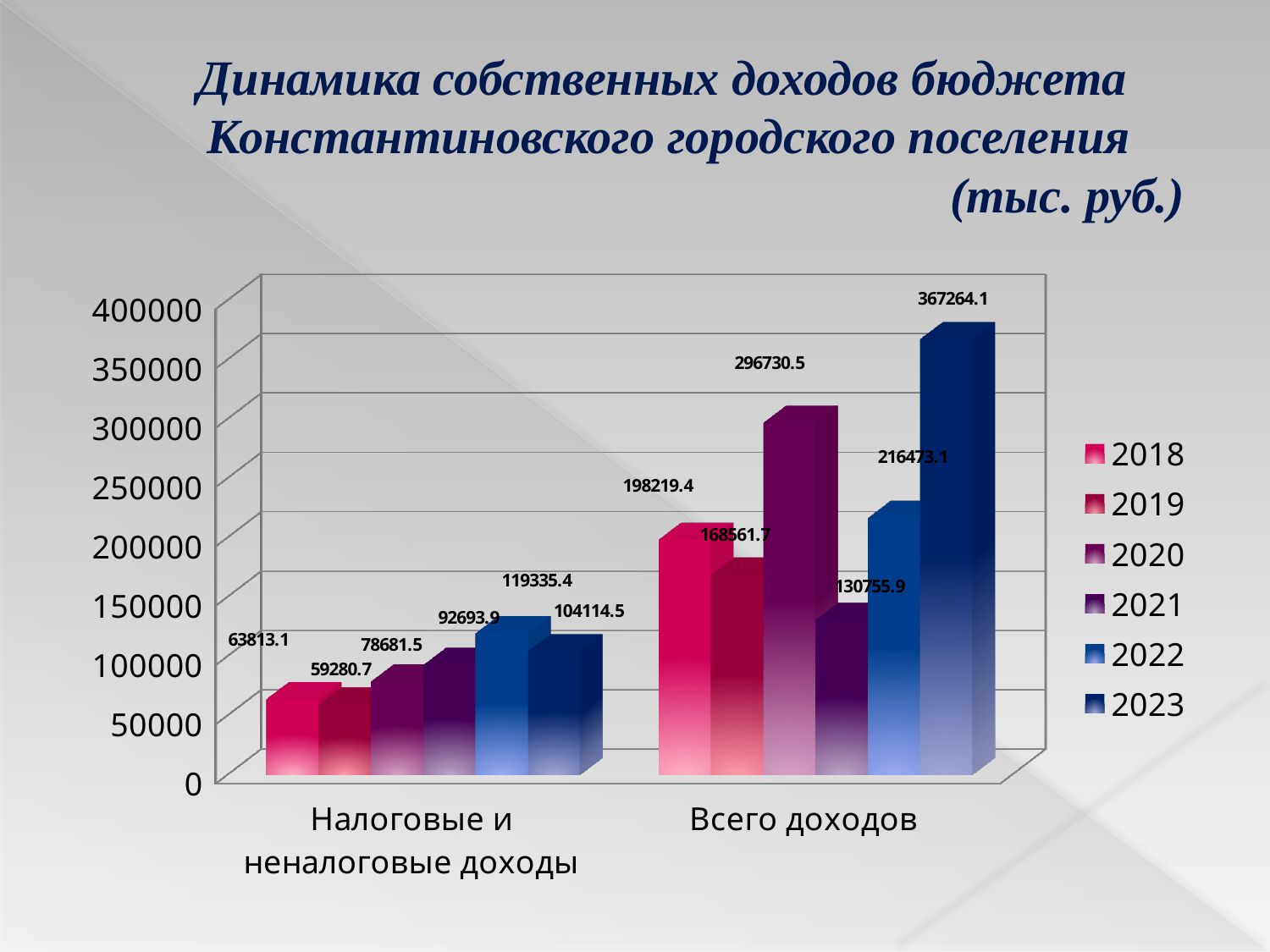
What unit is given in the chart title? тыс. руб. What is the value for 2021 in the "Всего доходов" category? 130755.9 Which year has the lowest value in the "Налоговые и неналоговые доходы" category? 2019 What is the value for 2023 in the "Всего доходов" category? 367264.1 What kind of chart is shown on the slide? Bar chart Which is larger in the "Налоговые и неналоговые доходы" category: the value for 2022 or the value for 2023? 2022 What is the value for 2019 in the "Налоговые и неналоговые доходы" category? 59280.7 What is the difference between the 2023 and 2022 values in the "Всего доходов" category? 150791.0 What is the value for 2022 in the "Налоговые и неналоговые доходы" category? 119335.4 How many categories are shown on the x axis? 2 Which year has the highest value in the "Всего доходов" category? 2023 How many series does the legend list? 6